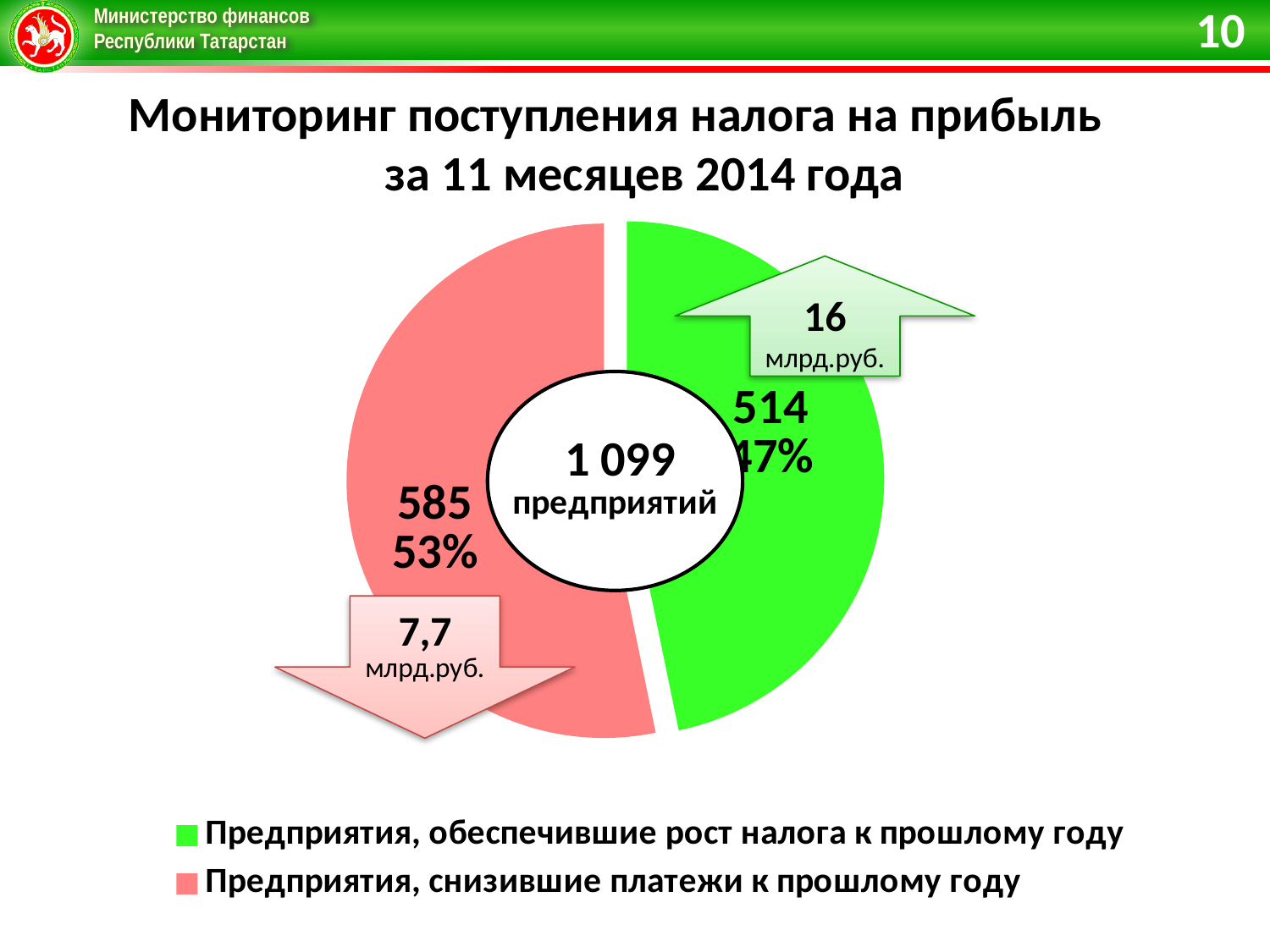
What is the difference between the number of enterprises that reduced payments (585) and those that increased tax (514)? 71 How many enterprises are in the category 'Предприятия, обеспечившие рост налога к прошлому году'? 514 How many enterprises are shown in the centre of the pie chart? 1 099 предприятий Which category has the smaller slice of the pie? Предприятия, обеспечившие рост налога к прошлому году How many slices does the pie chart have? 2 What amount is shown in the upward arrow next to the green slice? 16 млрд.руб. Which category has the larger slice of the pie? Предприятия, снизившие платежи к прошлому году How many enterprises are in the category 'Предприятия, снизившие платежи к прошлому году'? 585 What colour is the slice for 'Предприятия, снизившие платежи к прошлому году'? red (pink) How many entries does the legend list? 2 What share of the pie is taken by 'Предприятия, снизившие платежи к прошлому году'? 53% What kind of chart is shown on the slide? pie chart